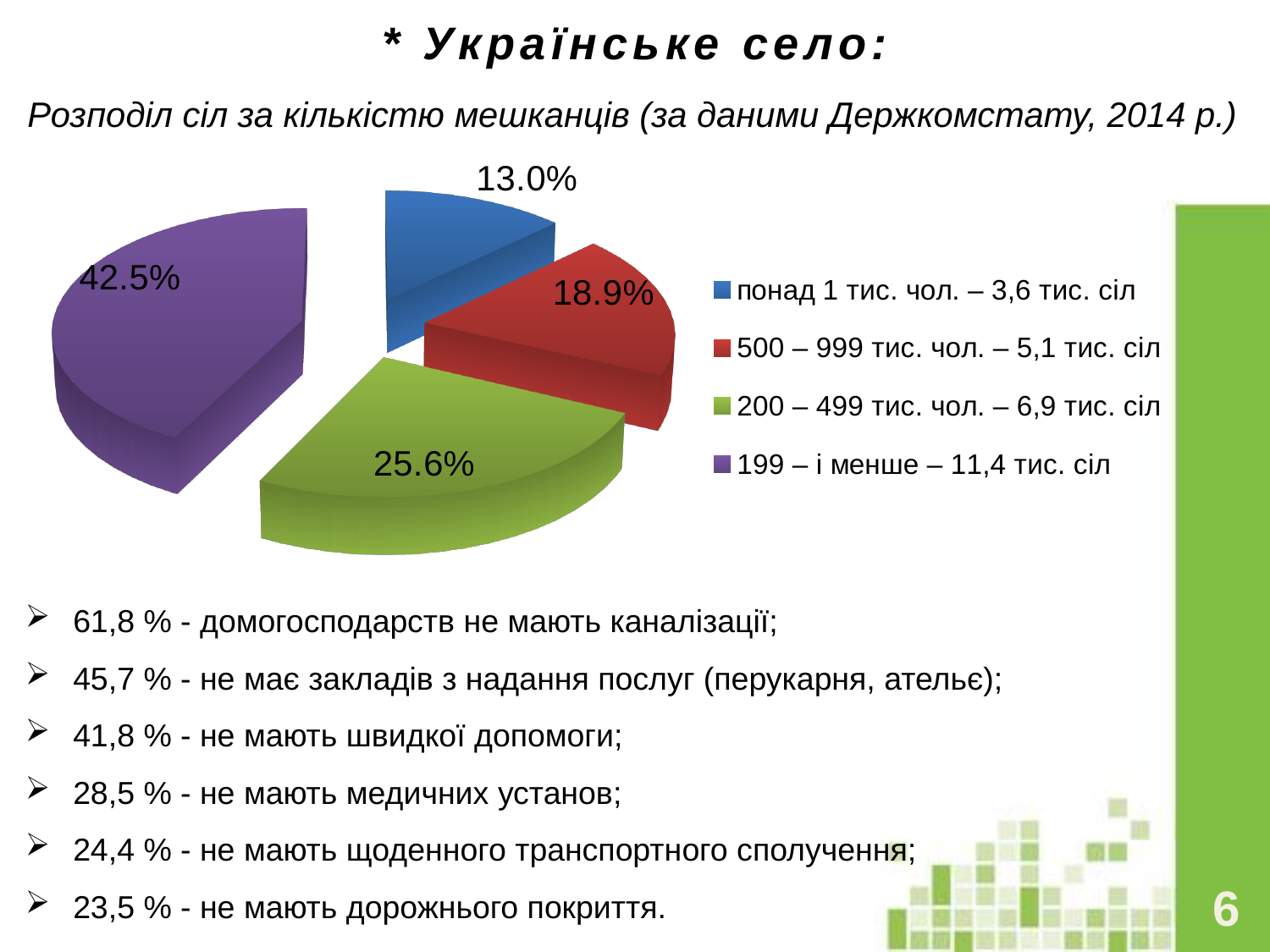
How many entries does the legend of the pie chart list? 4 Which category has the smallest share of the pie? понад 1 тис. чол. – 3,6 тис. сіл Which category has the largest share of the pie? 199 – і менше – 11,4 тис. сіл What percentage does the slice for "200 – 499 тис. чол. – 6,9 тис. сіл" show? 25.6% What is the difference in percentage points between the "199 – і менше" slice and the "200 – 499 тис. чол." slice? 16.9 How many slices does the pie chart have? 4 What percentage does the slice for "500 – 999 тис. чол. – 5,1 тис. сіл" show? 18.9% What percentage does the slice for "199 – і менше – 11,4 тис. сіл" show? 42.5% What kind of chart is shown on the slide? pie chart Which slice is larger: "500 – 999 тис. чол." or "понад 1 тис. чол."? 500 – 999 тис. чол. – 5,1 тис. сіл What colour is the slice representing "199 – і менше – 11,4 тис. сіл"? purple What percentage does the slice for "понад 1 тис. чол. – 3,6 тис. сіл" show? 13.0%